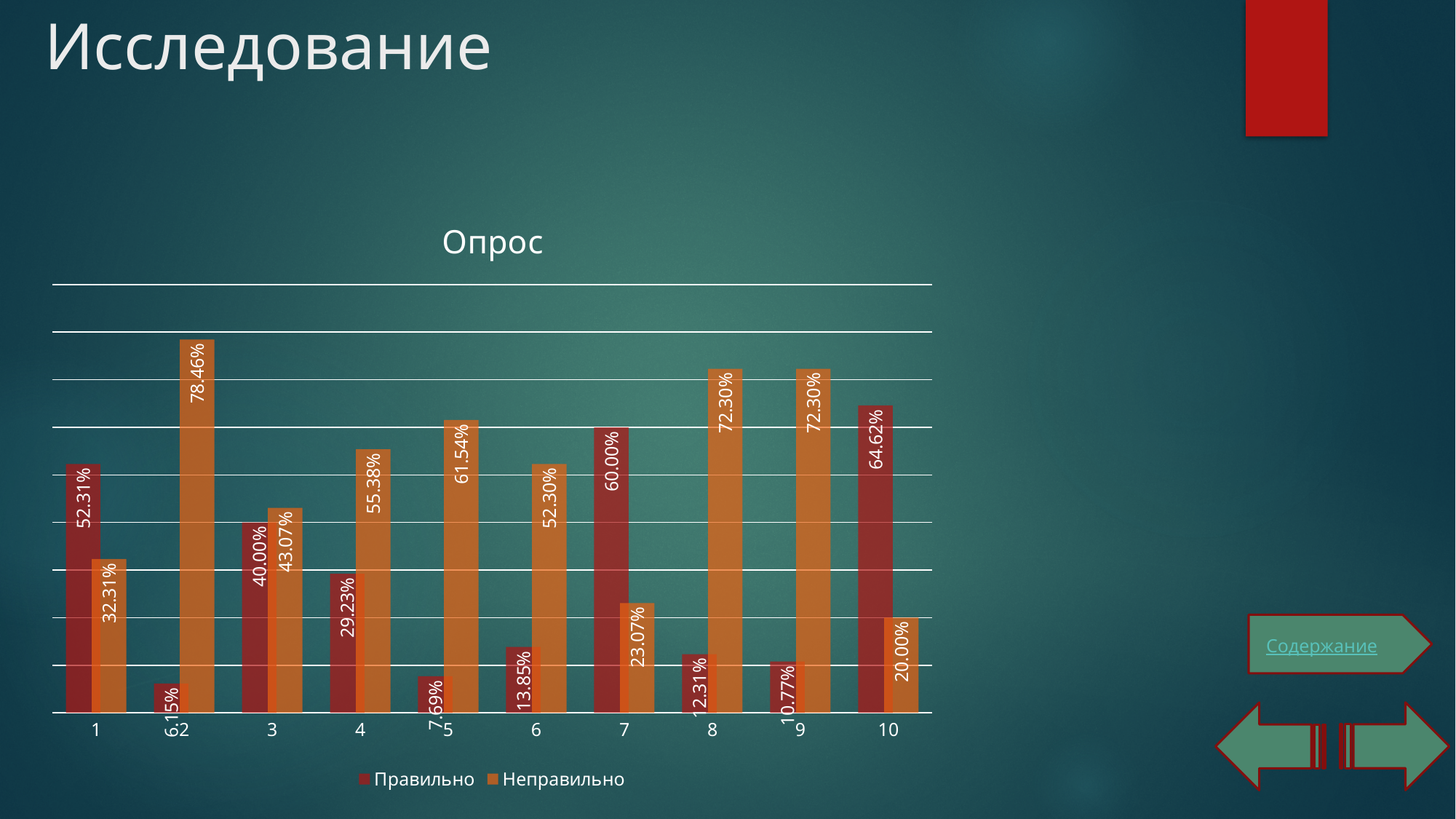
Which category has the highest Правильно value? 10 What is the value of Неправильно for category 10? 20.00% How many series does the legend list? 2 What is the value of Неправильно for category 2? 78.46% What is the value of Правильно for category 1? 52.31% How many categories are shown on the x axis? 10 What type of chart is shown? Bar chart For category 3, which is larger: Правильно or Неправильно? Неправильно What is the difference between Неправильно and Правильно for category 2? 72.31% What is the value of Правильно for category 7? 60.00% Which category has the highest Неправильно value? 2 Which category has the lowest Правильно value? 2